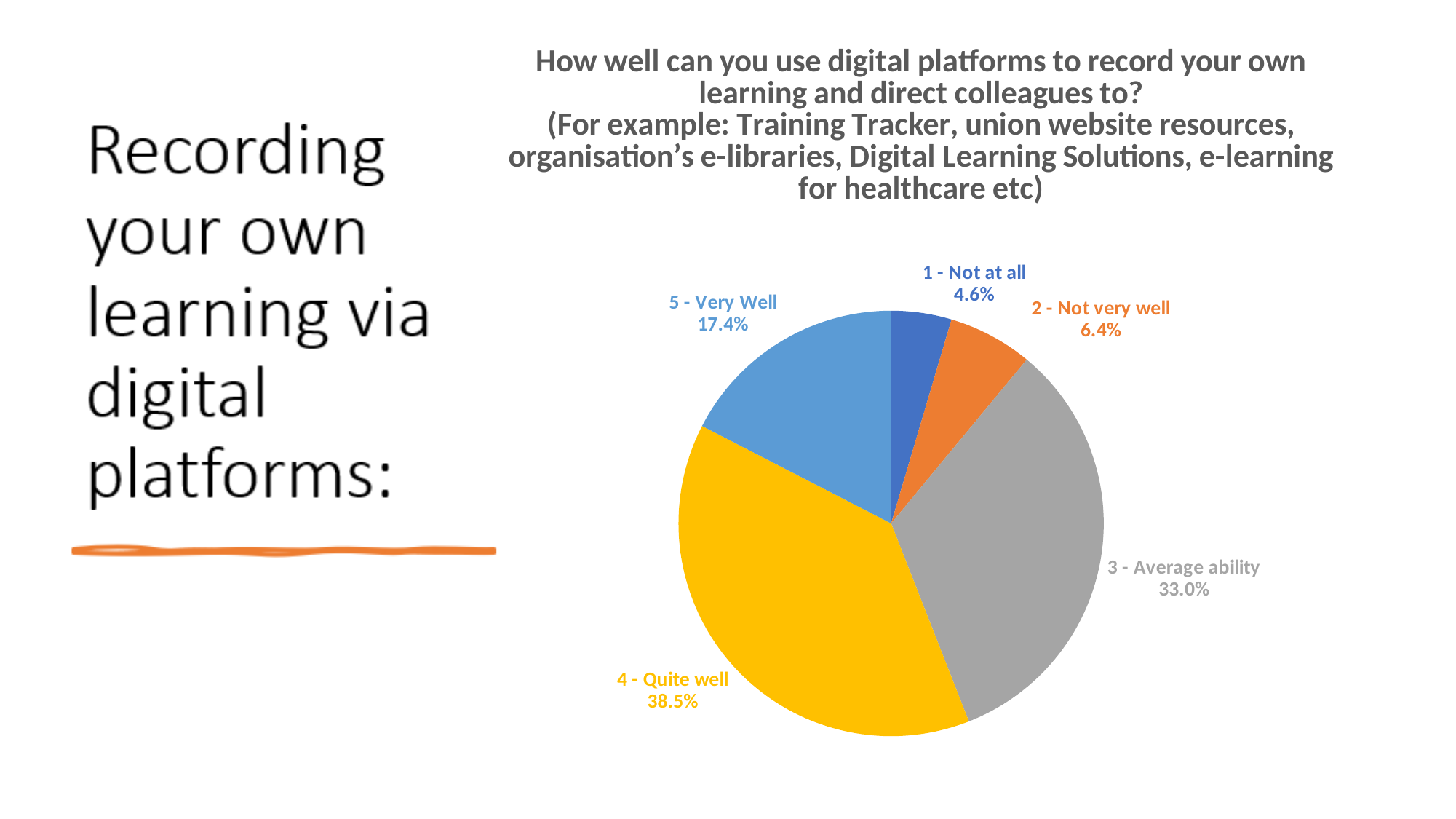
What type of chart is shown on the slide? pie chart What is the difference in percentage points between '4 - Quite well' and '3 - Average ability'? 5.5 What percentage of respondents answered '3 - Average ability'? 33.0% Which response category has the smallest share of the pie? 1 - Not at all Which response category has the largest share of the pie? 4 - Quite well What percentage of respondents answered '2 - Not very well'? 6.4% Which is larger: the share for '5 - Very Well' or the share for '2 - Not very well'? 5 - Very Well How many response categories are shown in the pie chart? 5 What percentage of respondents answered '1 - Not at all'? 4.6% What percentage of respondents answered '4 - Quite well'? 38.5% What percentage of respondents answered '5 - Very Well'? 17.4% What colour is the slice for '3 - Average ability'? grey